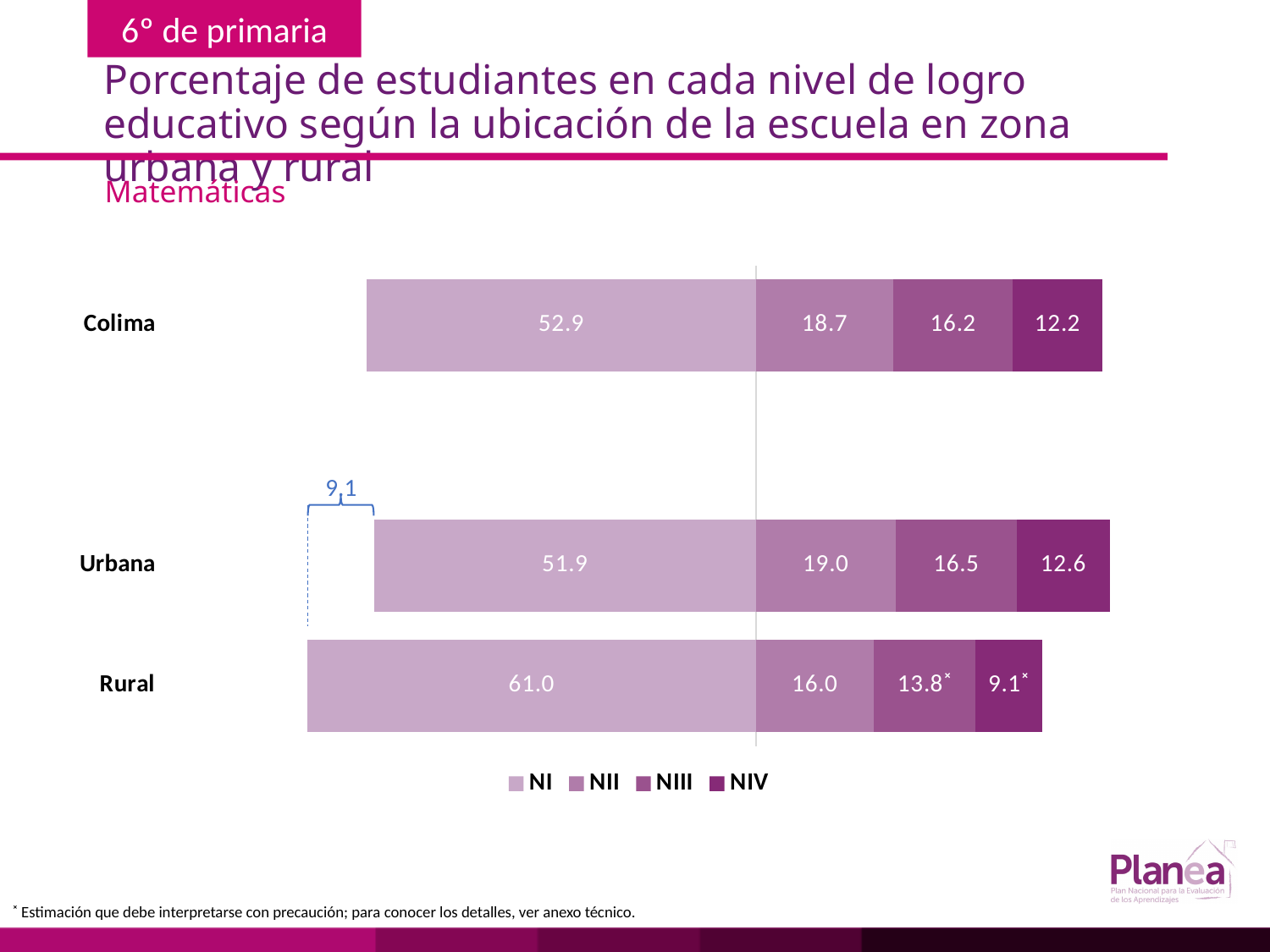
What is the NIV value for Urbana? 12.6 Which category has the lowest NIV value? Rural Which category has the highest NI value? Rural What is the total of the stacked bar for Colima? 100.0 What is the NI value for Colima? 52.9 What is the NI value for Rural? 61.0 What is the difference between the NI value for Rural and the NI value for Urbana? 9.1 What type of chart is shown on the slide? Stacked bar chart How many categories (bars) are shown in the chart? 3 Which is larger, the NIII value for Colima or the NIII value for Urbana? Urbana What is the NII value for Urbana? 19.0 How many series does the legend list? 4